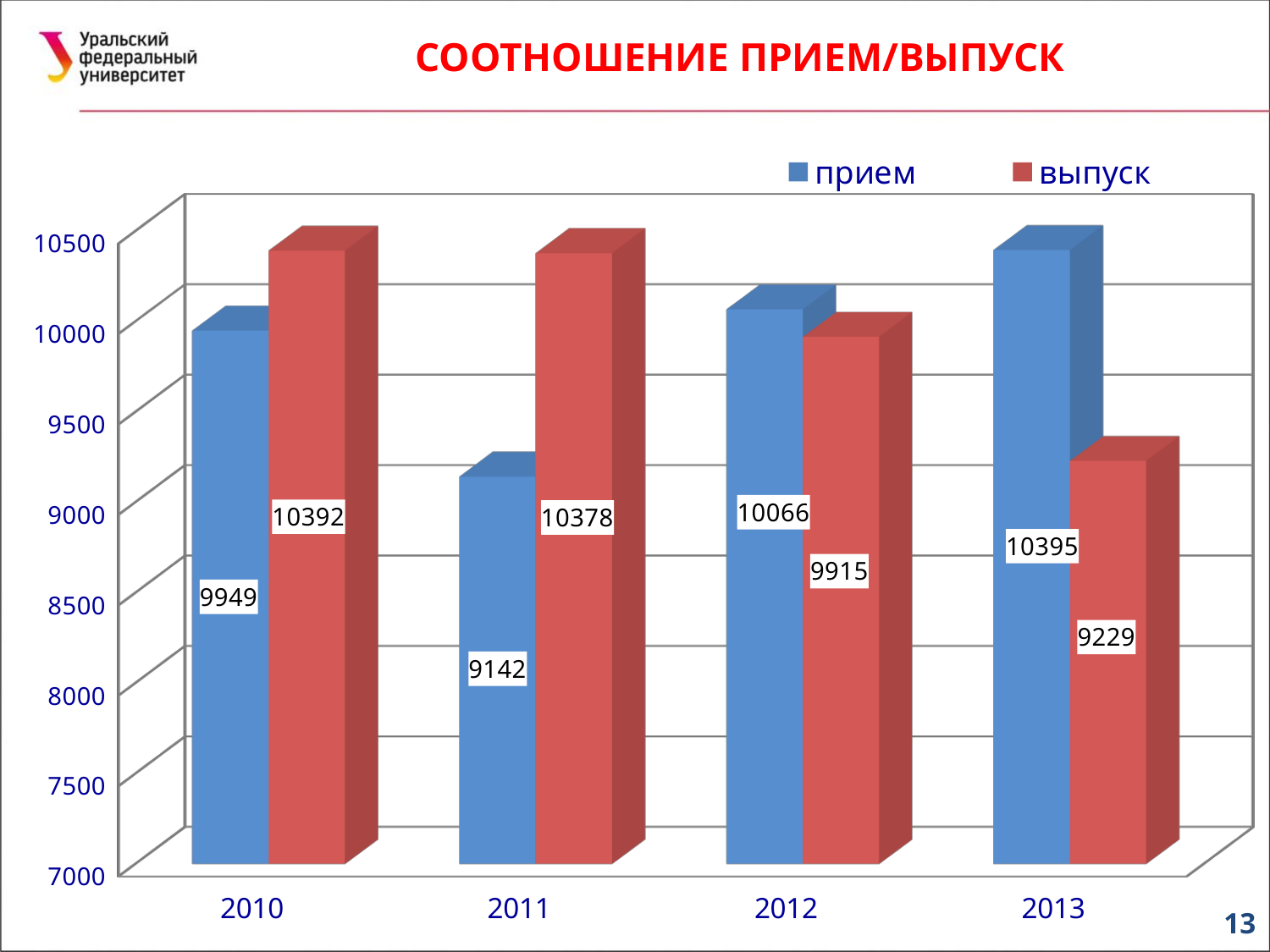
What kind of chart is shown on the slide? bar chart What is the difference between выпуск and прием in 2011? 1236 What is the value for выпуск in 2013? 9229 What is the value for прием in 2011? 9142 What is the title of the chart? СООТНОШЕНИЕ ПРИЕМ/ВЫПУСК How many years are shown on the x axis? 4 How many series does the legend list? 2 Which year has the highest value for прием? 2013 Which is larger in 2012, прием or выпуск? прием Which year has the lowest value for выпуск? 2013 Does the value for выпуск rise or fall from 2010 to 2013? fall What is the value for выпуск in 2010? 10392